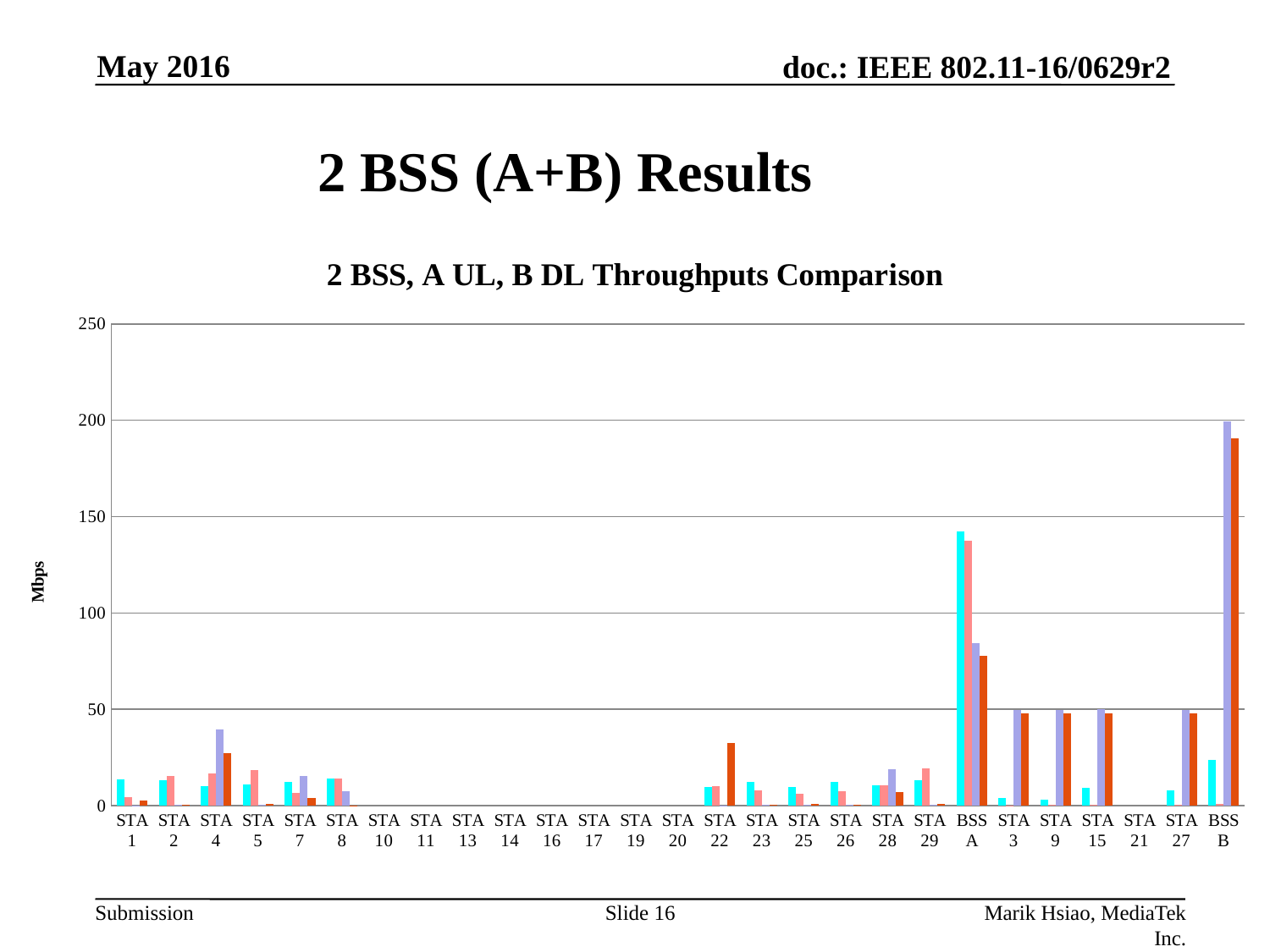
What is the title of the chart? 2 BSS, A UL, B DL Throughputs Comparison What is the label on the vertical axis of the chart? Mbps Which category has the tallest bar in the chart? BSS B What kind of chart is shown on the slide? bar chart Is the tallest bar for BSS A greater or less than 100? greater How many categories are shown along the x axis of the chart? 27 Is the tallest bar for BSS B greater or less than 150? greater Is the tallest bar for STA 9 greater or less than 100? less Which has a taller bar, STA 1 or STA 3? STA 3 Which has a taller bar, BSS A or BSS B? BSS B